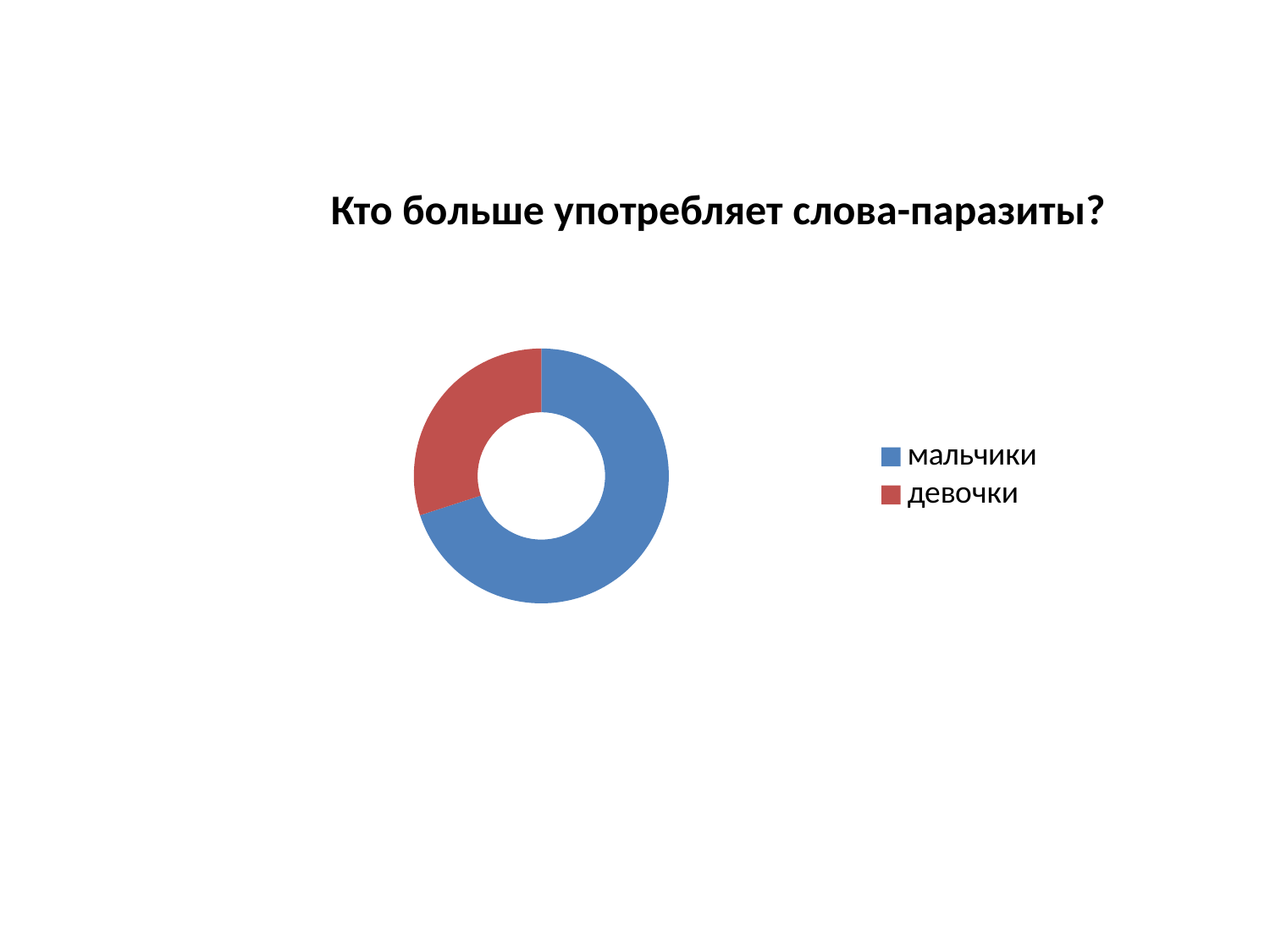
Which category has the smallest share of the chart? девочки Is the share for мальчики greater or less than half of the chart? greater What is the title of the chart? Кто больше употребляет слова-паразиты? How many categories does the legend list? 2 What colour represents девочки in the chart? Red Which is larger, the share for мальчики or the share for девочки? мальчики What kind of chart is shown on the slide? Doughnut (pie) chart Which category has the largest share of the chart? мальчики